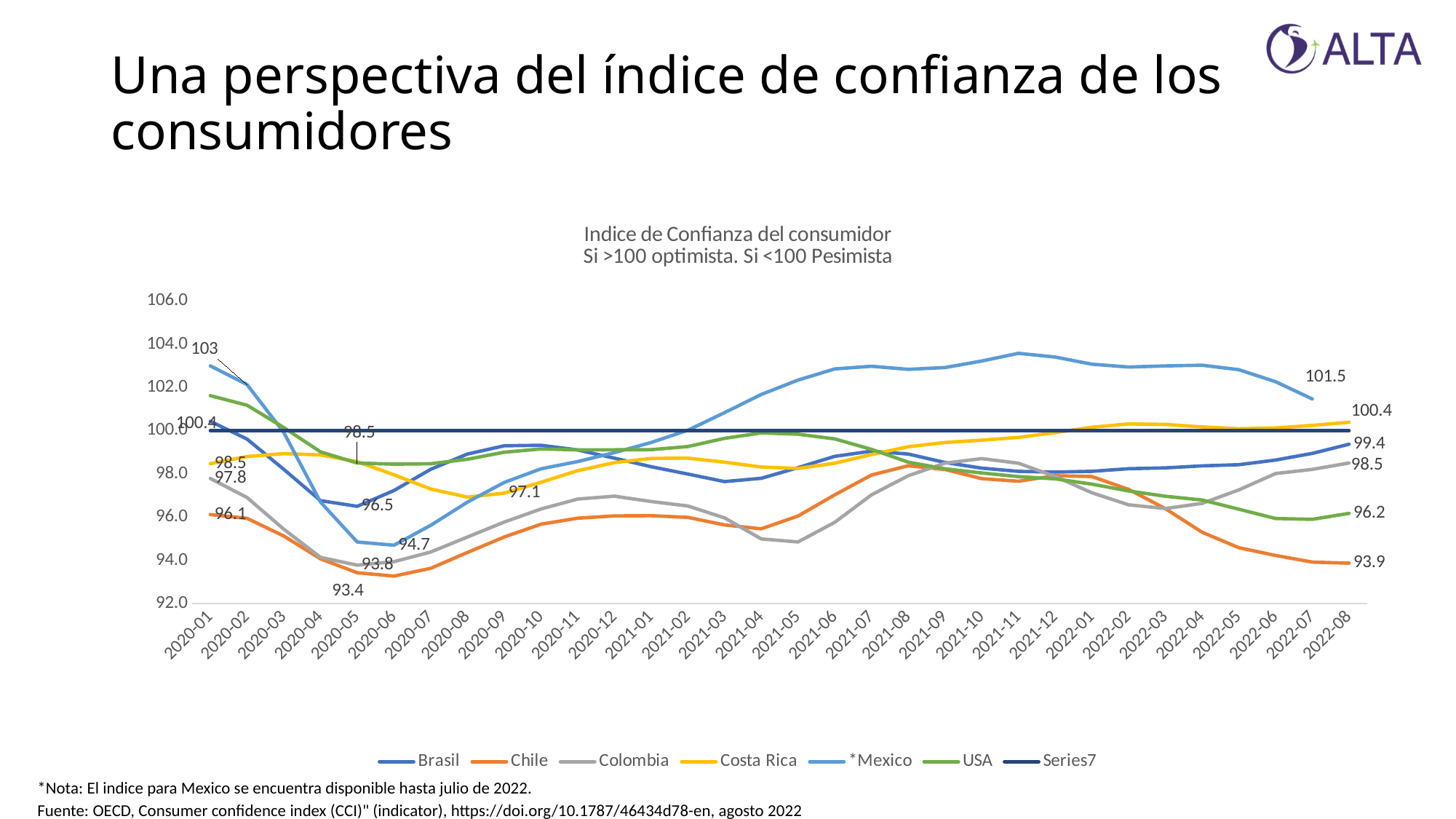
What is the value for Chile at 2022-08? 93.9 What is the value for *Mexico at 2022-07? 101.5 What is the difference between the *Mexico value at 2020-01 and at 2022-07? 1.5 What is the value for Costa Rica at 2022-08? 100.4 How many series does the legend list? 7 Which series has the lowest value at 2022-08? Chile How many months are shown along the x axis? 32 What is the value for Brasil at 2020-01? 100.4 What kind of chart is shown on the slide? line chart Which is larger at 2022-08, the value for Brasil or the value for USA? Brasil Is the value for *Mexico at 2021-11 greater or less than 102? greater Which series has the highest value at 2022-08? Costa Rica